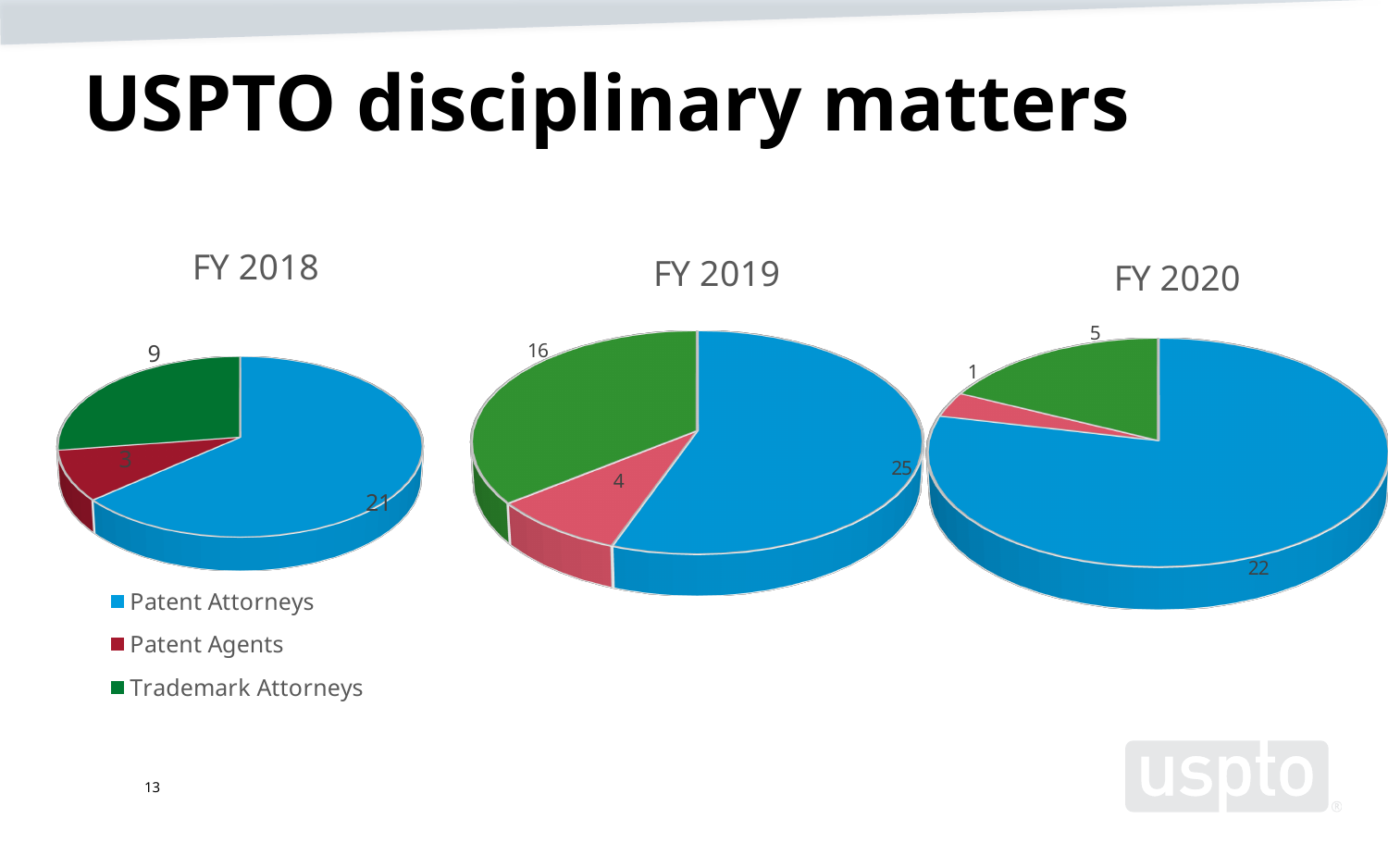
How many slices does the FY 2019 chart have? 3 In the FY 2019 chart, what is the value for Trademark Attorneys? 16 How many entries does the legend list? 3 In the FY 2020 chart, what is the value for Patent Agents? 1 In the FY 2018 chart, what is the value for Patent Attorneys? 21 In the FY 2018 chart, which category has the smallest slice? Patent Agents In the FY 2020 chart, which category has the largest slice? Patent Attorneys Which colour represents Trademark Attorneys in the legend? Green In the FY 2019 chart, what is the difference between the Patent Attorneys value and the Trademark Attorneys value? 9 In the FY 2020 chart, what is the total of all slices? 28 What kind of chart is the FY 2020 chart? Pie chart In the FY 2018 chart, which is larger: Trademark Attorneys or Patent Agents? Trademark Attorneys